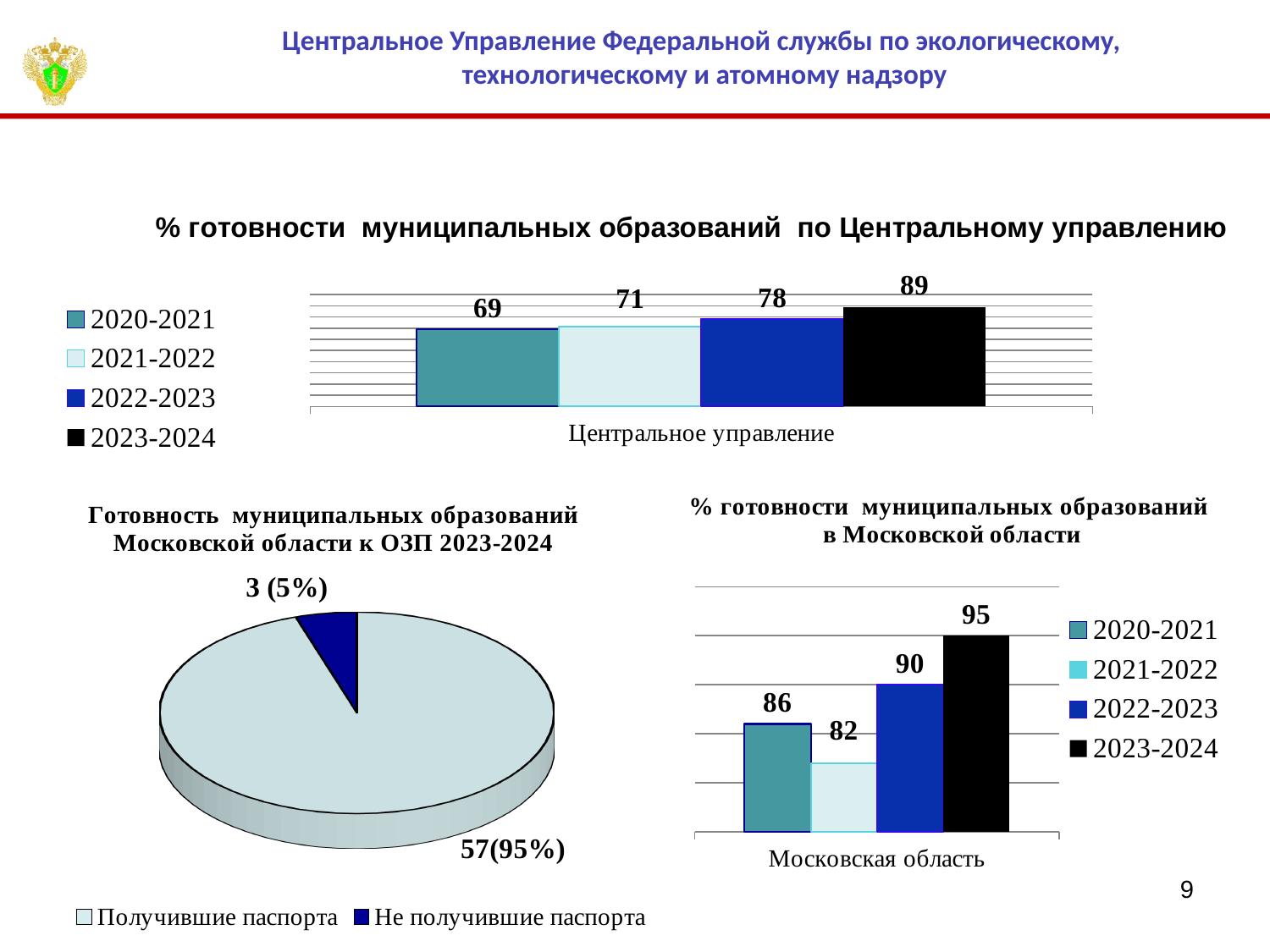
In the top chart '% готовности муниципальных образований по Центральному управлению', what is the value for 2020-2021? 69 In the top chart '% готовности муниципальных образований по Центральному управлению', what is the difference between the 2023-2024 and 2022-2023 values? 11 In the bottom-right chart '% готовности муниципальных образований в Московской области', which is larger, the value for 2020-2021 or for 2021-2022? 2020-2021 In the bottom-right chart '% готовности муниципальных образований в Московской области', which series has the highest value? 2023-2024 In the top chart '% готовности муниципальных образований по Центральному управлению', which series has the lowest value? 2020-2021 In the bottom-right chart '% готовности муниципальных образований в Московской области', what is the difference between the 2023-2024 and 2020-2021 values? 9 In the top chart '% готовности муниципальных образований по Центральному управлению', what is the value for 2023-2024? 89 In the top chart '% готовности муниципальных образований по Центральному управлению', do the values rise or fall from 2020-2021 to 2023-2024? rise What kind of chart is the bottom-left chart 'Готовность муниципальных образований Московской области к ОЗП 2023-2024'? pie chart In the bottom-left pie chart 'Готовность муниципальных образований Московской области к ОЗП 2023-2024', what share of the pie is 'Не получившие паспорта'? 5% How many series does the legend of the top chart '% готовности муниципальных образований по Центральному управлению' list? 4 In the bottom-right chart '% готовности муниципальных образований в Московской области', what is the value for 2021-2022? 82